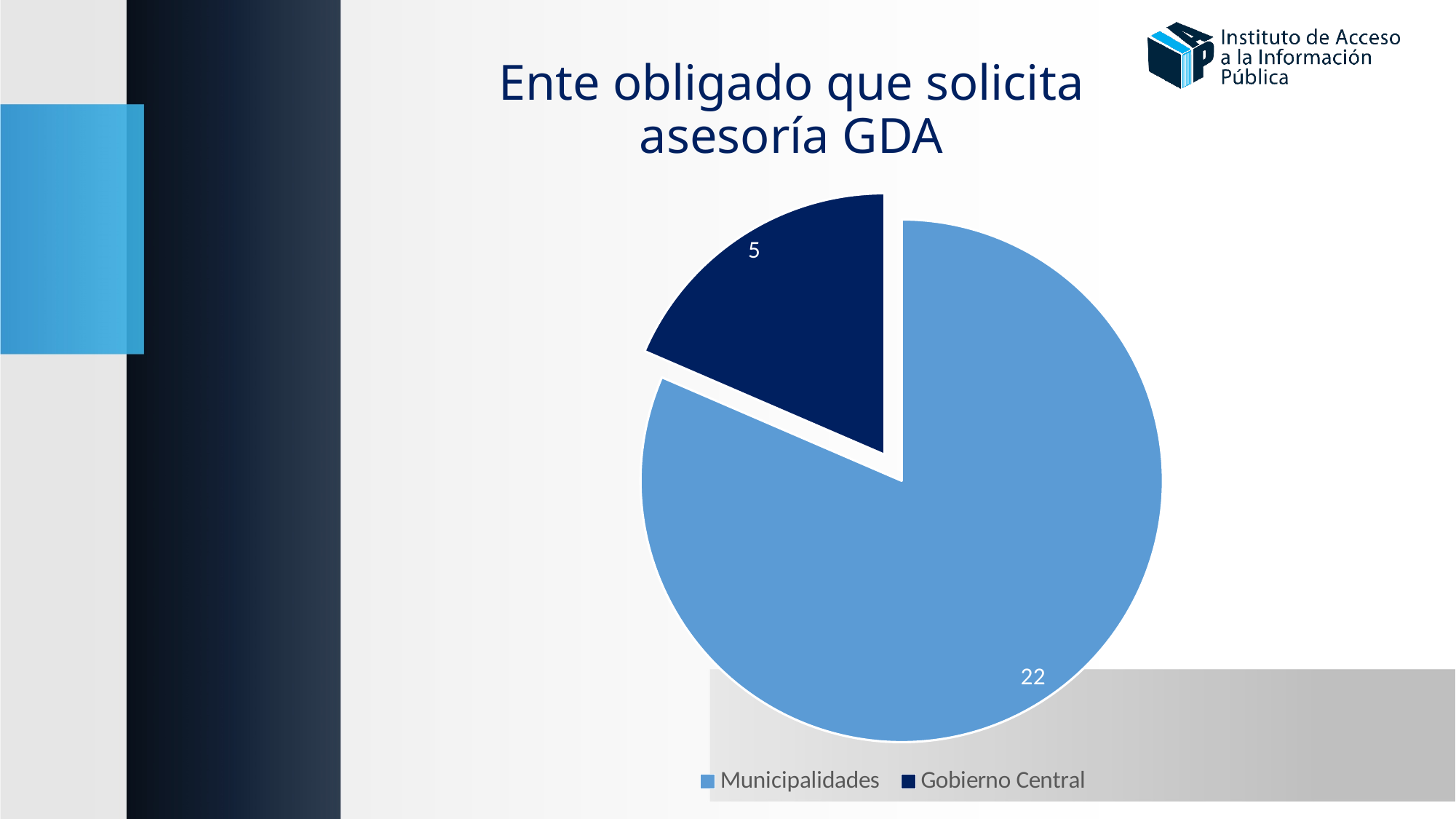
Which category has the largest slice of the pie? Municipalidades Which category has the smallest slice of the pie? Gobierno Central What is the total of all slices in the pie chart? 27 Which is larger, the value for Municipalidades or the value for Gobierno Central? Municipalidades What is the value for Municipalidades? 22 How many categories does the pie chart show? 2 What is the title of the chart? Ente obligado que solicita asesoría GDA What is the difference between the values for Municipalidades and Gobierno Central? 17 What kind of chart is shown on the slide? Pie chart Which category is shown in dark blue in the legend? Gobierno Central What is the value for Gobierno Central? 5